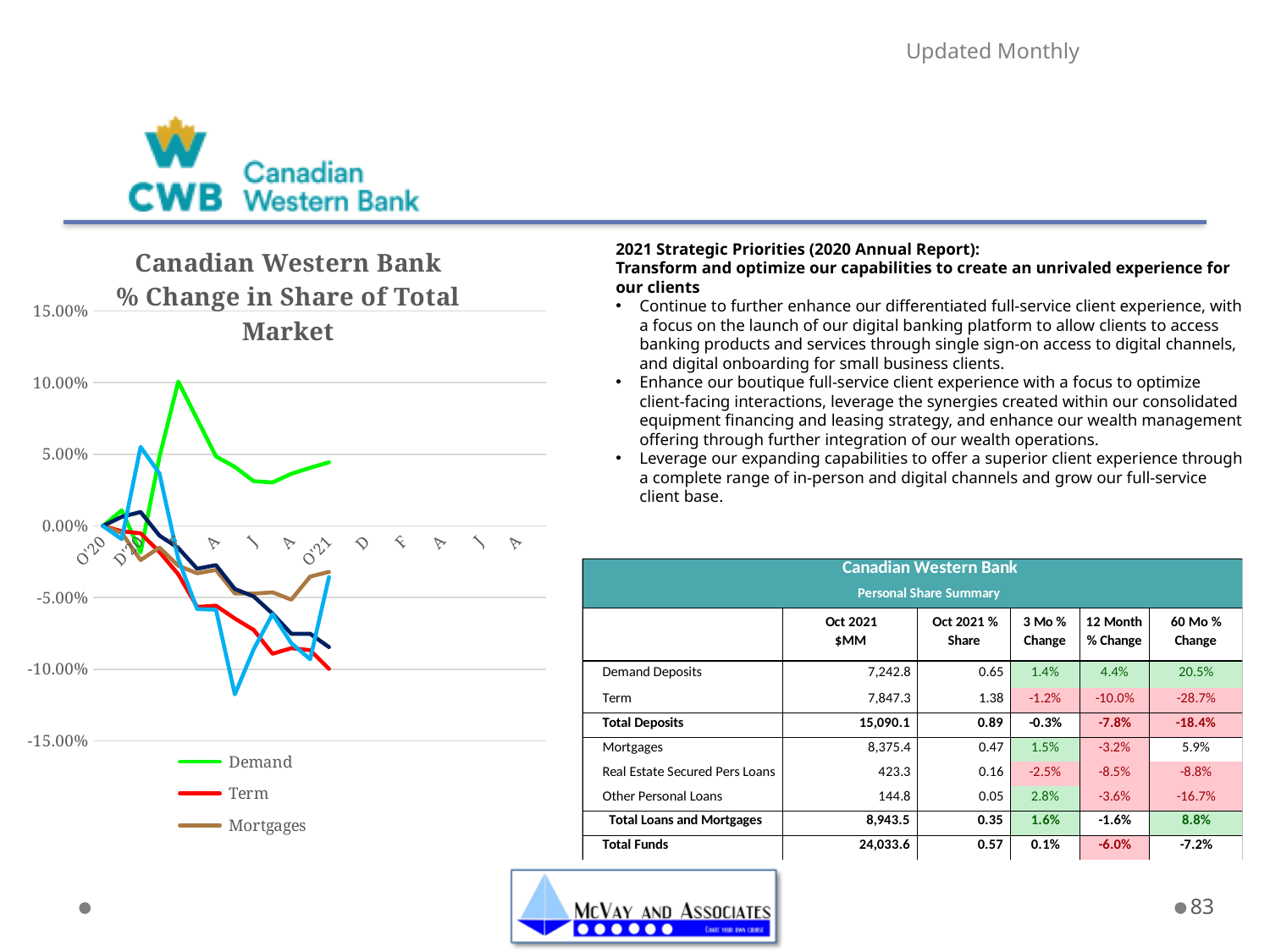
Is the value for Mortgages at O'21 greater or less than -5.00%? greater Is the value for Demand at O'21 greater or less than 0.00%? greater Which series has the highest value at O'21? Demand Does the Term series rise or fall overall from O'20 to O'21? fall Which series are listed in the chart's legend? Demand, Term, Mortgages Which series has the lowest value at O'21? Term What is the title of the chart on the slide? Canadian Western Bank % Change in Share of Total Market How many series does the chart's legend list? 3 Is the value for Demand at O'21 greater or less than 5.00%? less What kind of chart is shown on the slide? line chart At O'21, is the value for Demand or Term larger? Demand